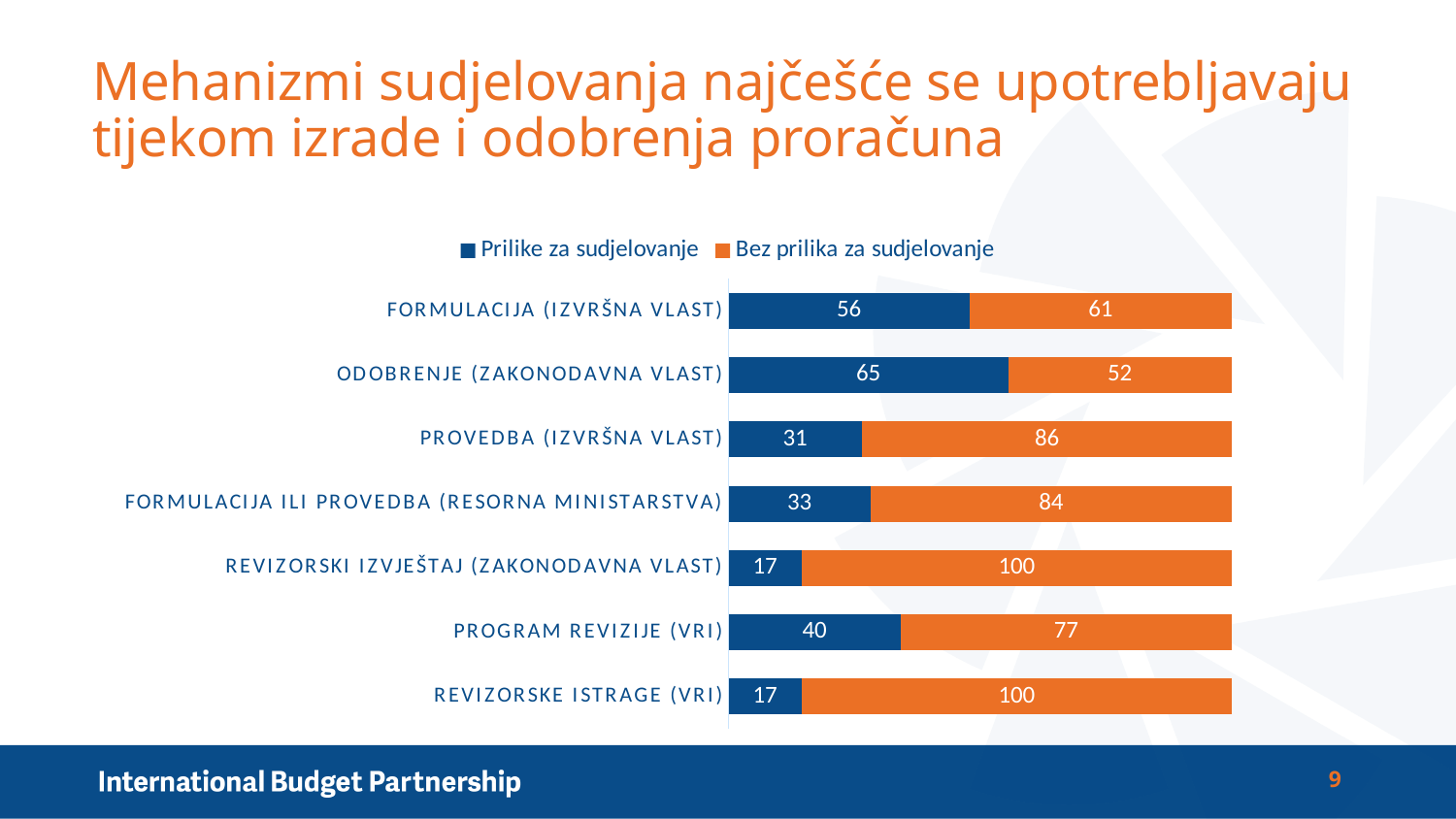
What is the difference between the 'Bez prilika za sudjelovanje' value and the 'Prilike za sudjelovanje' value for FORMULACIJA ILI PROVEDBA (RESORNA MINISTARSTVA)? 51 What is the total of the stacked bar for REVIZORSKI IZVJEŠTAJ (ZAKONODAVNA VLAST)? 117 Which colour represents 'Bez prilika za sudjelovanje' in the chart? Orange Which is larger for FORMULACIJA (IZVRŠNA VLAST): 'Prilike za sudjelovanje' or 'Bez prilika za sudjelovanje'? Bez prilika za sudjelovanje Which category has the highest value for 'Prilike za sudjelovanje'? ODOBRENJE (ZAKONODAVNA VLAST) Which category has the lowest value for 'Bez prilika za sudjelovanje'? ODOBRENJE (ZAKONODAVNA VLAST) How many categories are shown in the chart? 7 How many series does the legend list? 2 What is the value of 'Prilike za sudjelovanje' for ODOBRENJE (ZAKONODAVNA VLAST)? 65 What kind of chart is shown on the slide? Stacked bar chart What is the value of 'Bez prilika za sudjelovanje' for PROVEDBA (IZVRŠNA VLAST)? 86 What is the value of 'Prilike za sudjelovanje' for PROGRAM REVIZIJE (VRI)? 40